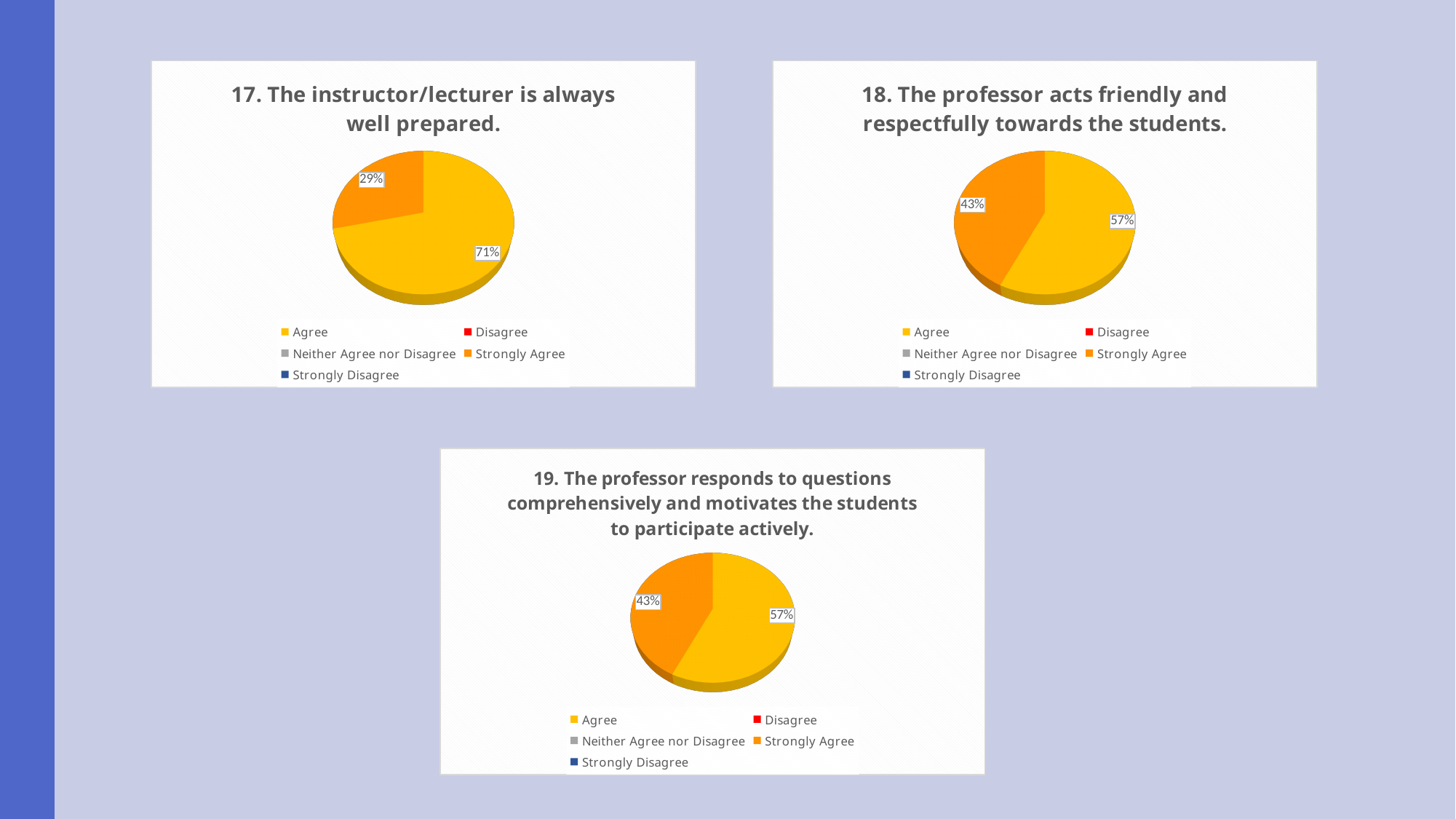
In the chart titled "19. The professor responds to questions comprehensively and motivates the students to participate actively.", which category has the largest share? Agree In the chart titled "17. The instructor/lecturer is always well prepared.", which category has the largest share? Agree In the chart titled "18. The professor acts friendly and respectfully towards the students.", which is larger, Agree or Strongly Agree? Agree In the chart titled "17. The instructor/lecturer is always well prepared.", what is the difference in percentage points between Agree and Strongly Agree? 42 How many entries does the legend list in the chart titled "17. The instructor/lecturer is always well prepared."? 5 In the chart titled "18. The professor acts friendly and respectfully towards the students.", what percentage of responses are Agree? 57% In the chart titled "17. The instructor/lecturer is always well prepared.", what percentage of responses are Agree? 71% In the chart titled "18. The professor acts friendly and respectfully towards the students.", what percentage of responses are Strongly Agree? 43% In the chart titled "19. The professor responds to questions comprehensively and motivates the students to participate actively.", what percentage of responses are Strongly Agree? 43% How many charts are shown on the slide? 3 In the chart titled "17. The instructor/lecturer is always well prepared.", what percentage of responses are Strongly Agree? 29% What kind of chart is the chart titled "19. The professor responds to questions comprehensively and motivates the students to participate actively."? Pie chart